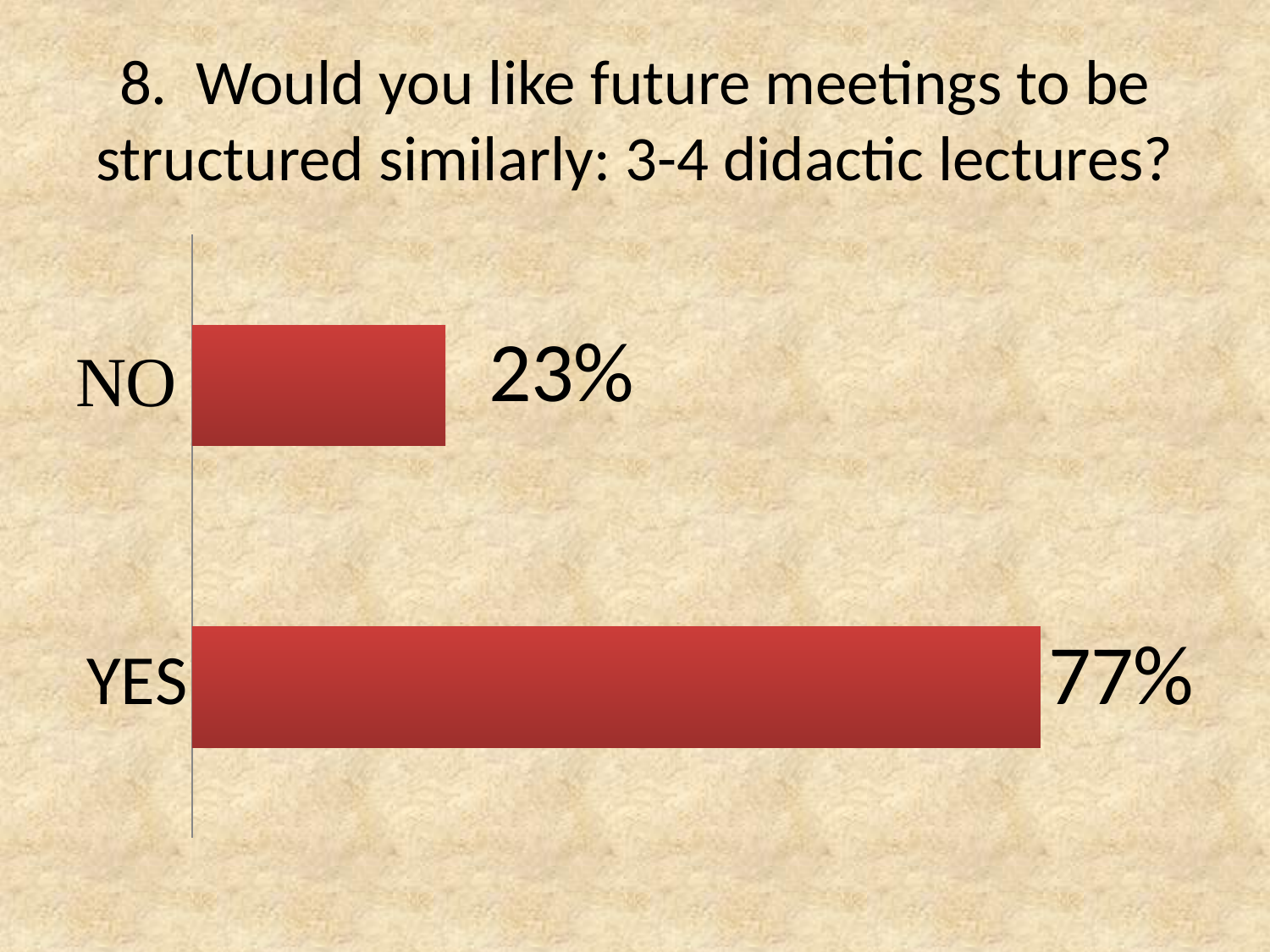
What kind of chart is shown on the slide? Bar chart What colour are the bars in the chart? Red Which is larger, the value for YES or the value for NO? YES What percentage of respondents answered YES? 77% Which response has the highest value? YES What is the difference between the YES and NO percentages? 54% What question does the chart on the slide present results for? Would you like future meetings to be structured similarly: 3-4 didactic lectures? What is the total of the YES and NO percentages? 100% How many response categories are shown in the chart? 2 Which response has the lowest value? NO What percentage of respondents answered NO? 23%